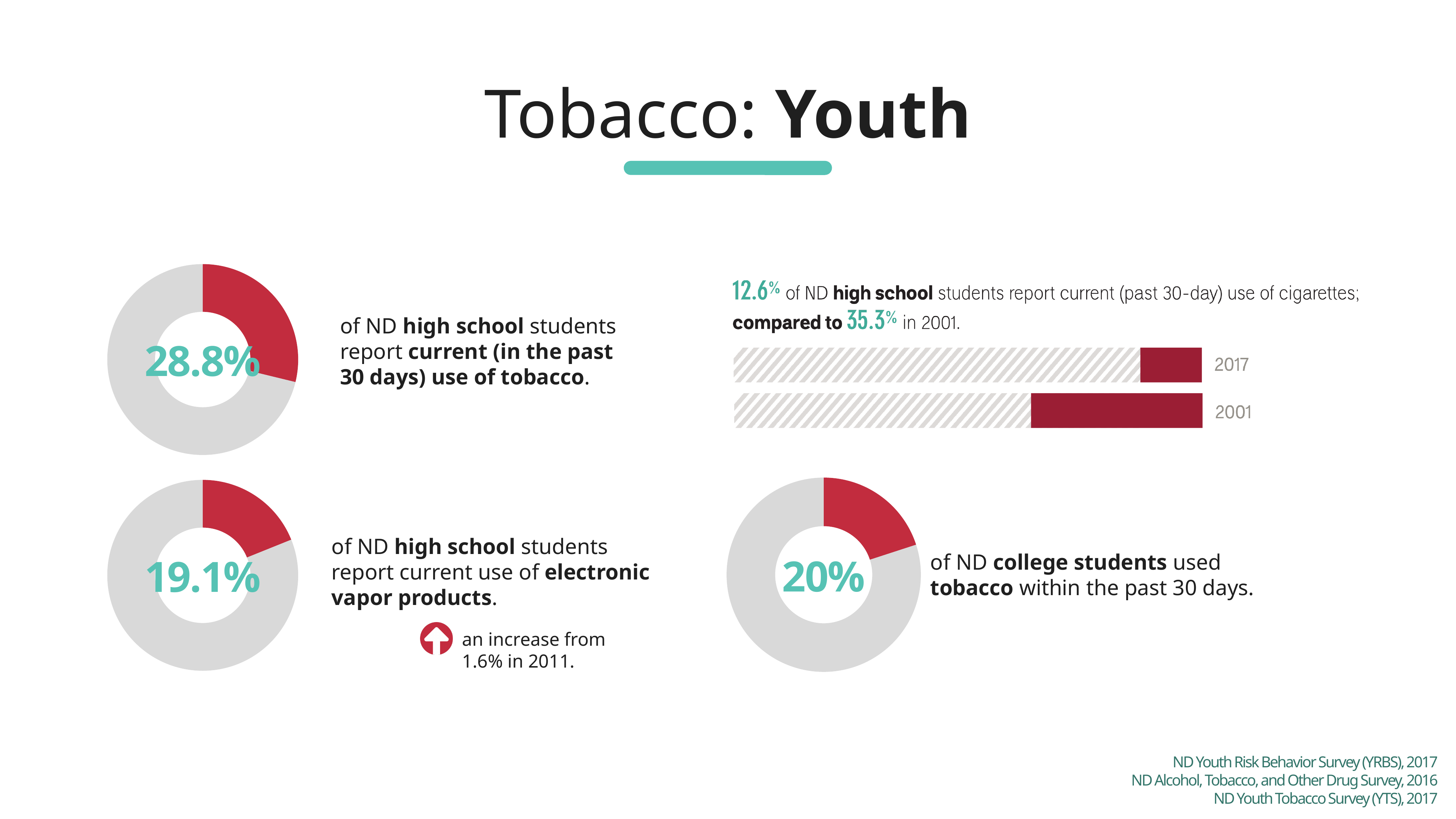
In the bar chart on the right about current cigarette use among ND high school students, what is the value for 2001? 35.3% How many bars are shown in the bar chart on the right? 2 According to the bar chart on the right, did current cigarette use among ND high school students rise or fall from 2001 to 2017? Fall What kind of chart is used on the right to compare cigarette use in 2017 and 2001? Bar chart Comparing the two left-hand donut charts, which is larger: the share of ND high school students reporting current tobacco use or the share reporting current use of electronic vapor products? Current tobacco use (28.8%) In the top-left donut chart, what percentage of ND high school students report current (in the past 30 days) use of tobacco? 28.8% In the bottom-right donut chart, what percentage of ND college students used tobacco within the past 30 days? 20% In the bar chart on the right about current cigarette use among ND high school students, what is the value for 2017? 12.6% In the bottom-left donut chart, what percentage of ND high school students report current use of electronic vapor products? 19.1% In the bar chart on the right, by how many percentage points did current cigarette use among ND high school students differ between 2001 and 2017? 22.7 percentage points In the bar chart on the right, which year has the larger value for current cigarette use, 2017 or 2001? 2001 What kind of chart is used to show the 28.8% figure on the left of the slide? Donut chart